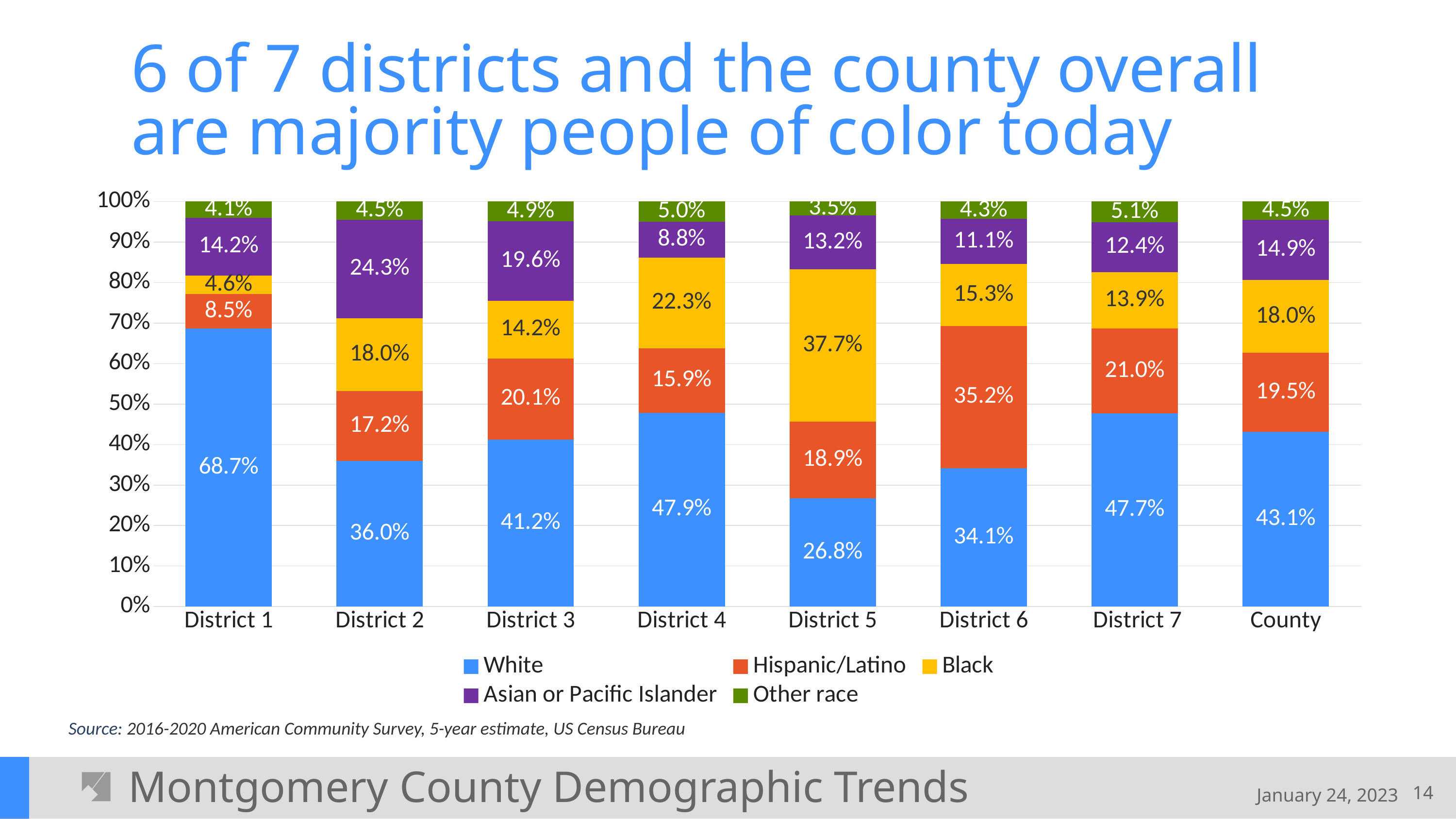
What is the White share for District 1? 68.7% What kind of chart is shown on the slide? Stacked bar chart What is the difference in percentage points between the Hispanic/Latino share in District 6 and in District 1? 26.7 What is the Hispanic/Latino share for the County? 19.5% What is the Asian or Pacific Islander share for District 2? 24.3% How many series does the legend list? 5 What is the Black share for District 5? 37.7% Which category has the highest Hispanic/Latino share? District 6 Which category has the highest White share? District 1 Which is larger, the Black share in District 4 or the Black share in District 3? District 4 Which category has the lowest White share? District 5 How many categories are shown on the x axis? 8